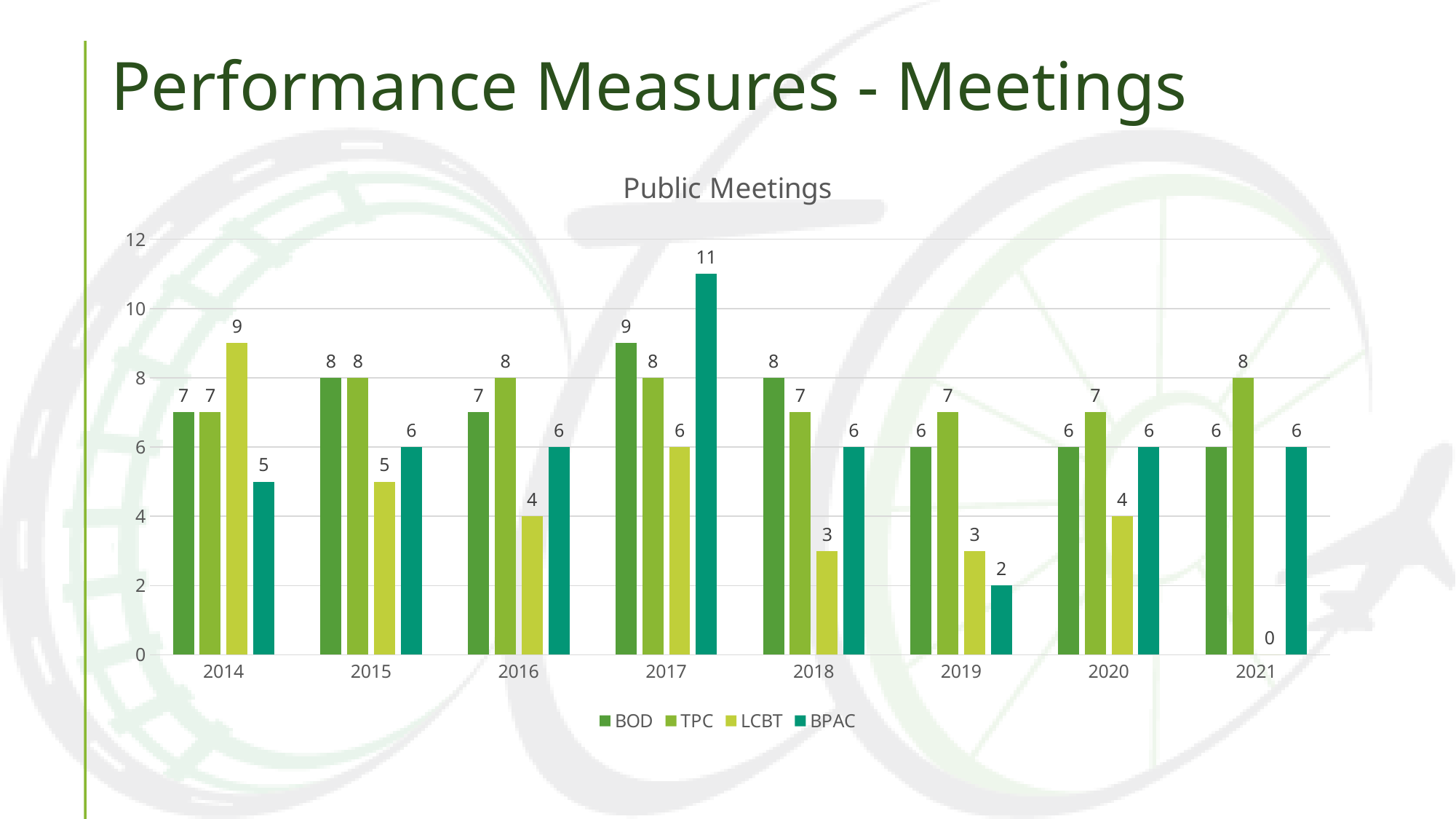
In which year is the BPAC value highest? 2017 What is the difference between the BOD value in 2017 and the BOD value in 2019? 3 What is the value for BOD in 2018? 8 What is the difference between the BPAC value and the LCBT value in 2017? 5 In which year is the LCBT value lowest? 2021 What is the title of the chart? Public Meetings How many years are shown on the x axis? 8 What kind of chart is shown on the slide? bar chart How many series does the legend list? 4 Which is larger in 2014, the LCBT value or the BPAC value? LCBT What is the value for LCBT in 2021? 0 What is the value for BPAC in 2017? 11